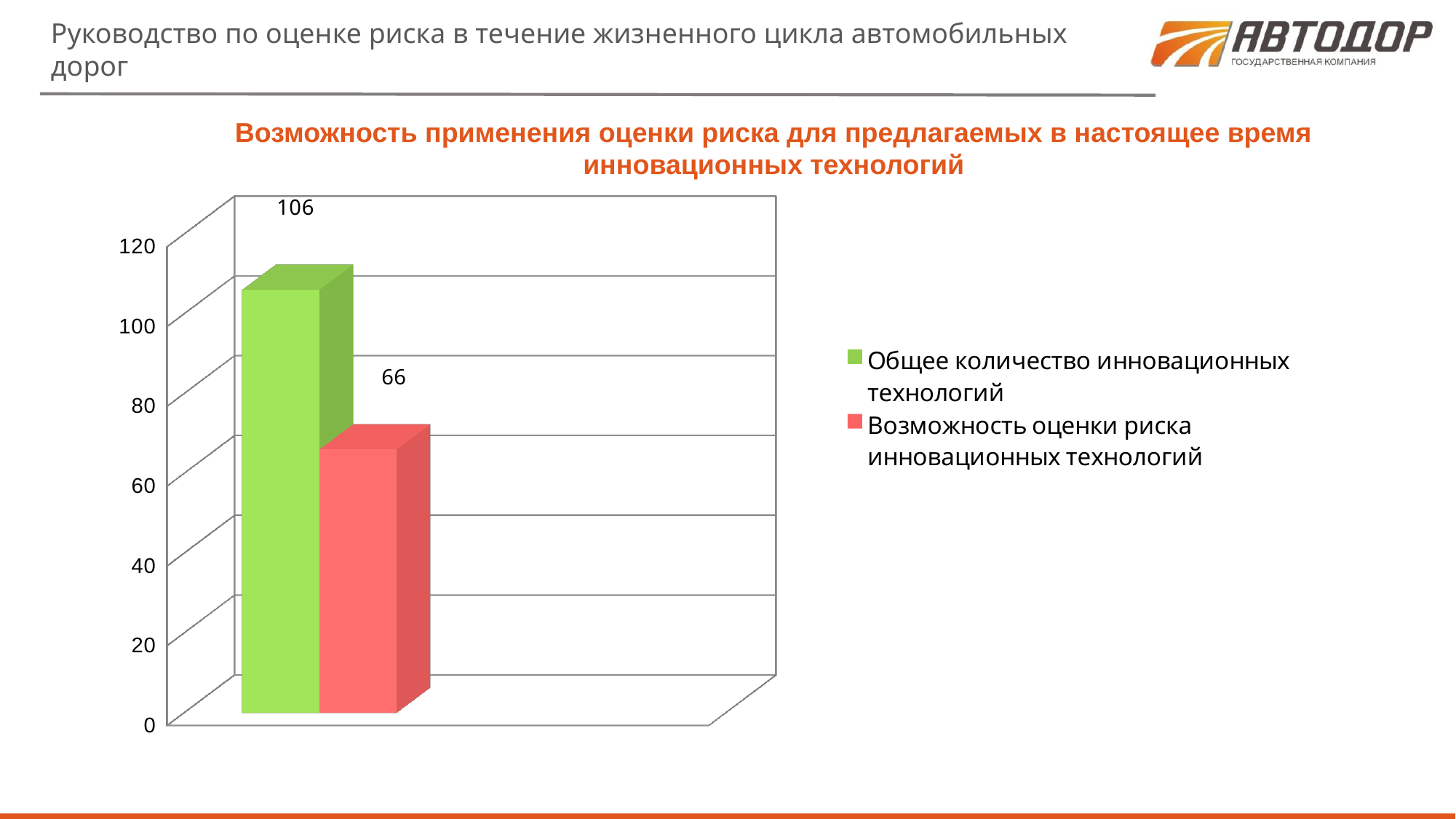
Is the value for 'Общее количество инновационных технологий' larger than the value for 'Возможность оценки риска инновационных технологий'? Yes Which series has the higher value? Общее количество инновационных технологий What kind of chart is shown on the slide? Bar chart What colour is the bar for 'Возможность оценки риска инновационных технологий'? Red What is the title of the chart? Возможность применения оценки риска для предлагаемых в настоящее время инновационных технологий Is the value for 'Общее количество инновационных технологий' greater or less than 100? greater How many series does the legend list? 2 What is the value for 'Общее количество инновационных технологий'? 106 What is the difference between the values for 'Общее количество инновационных технологий' and 'Возможность оценки риска инновационных технологий'? 40 What is the value for 'Возможность оценки риска инновационных технологий'? 66 Is the value for 'Возможность оценки риска инновационных технологий' greater or less than 80? less Which series has the lower value? Возможность оценки риска инновационных технологий